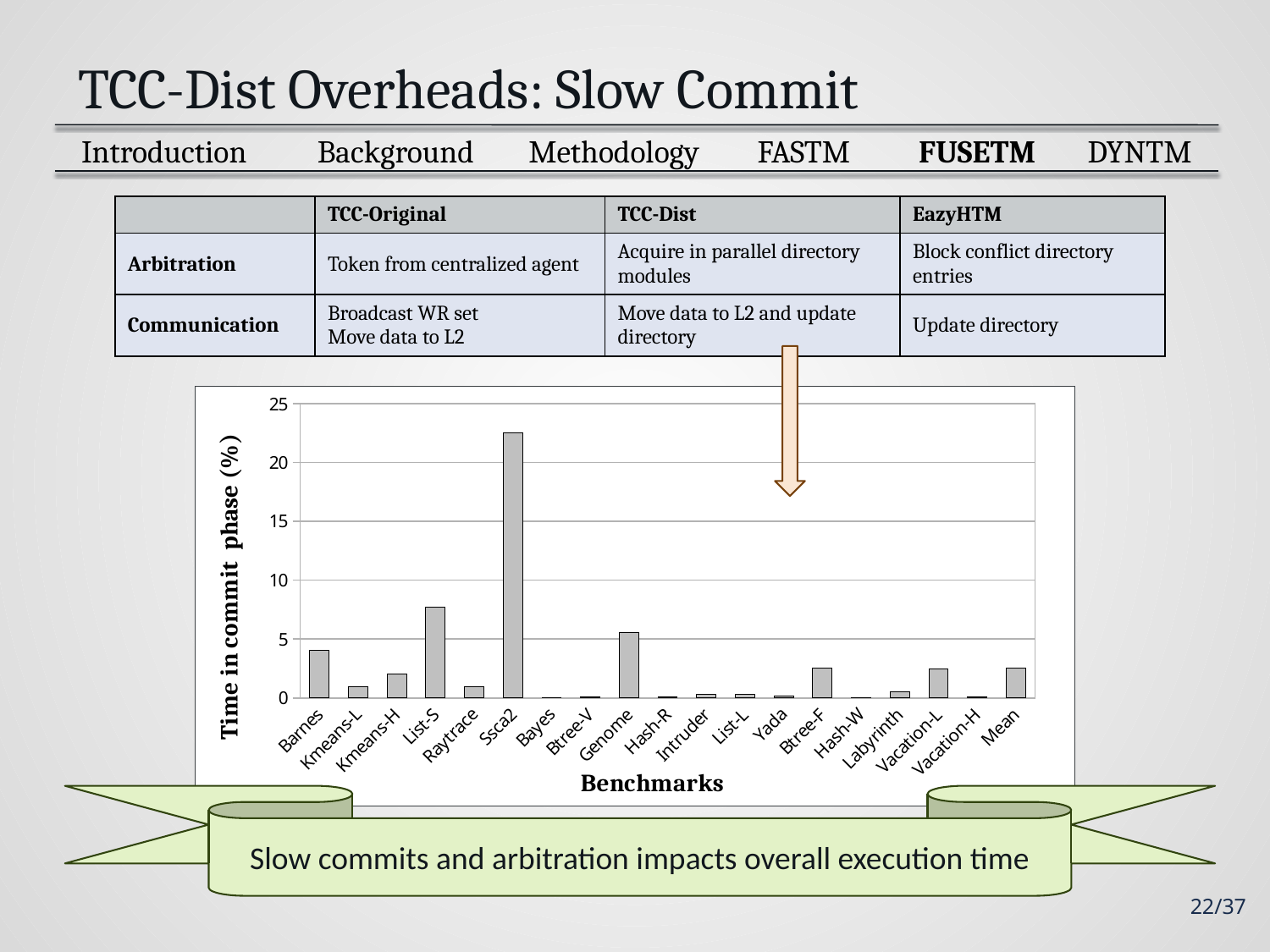
What is the label of the y axis of the chart? Time in commit phase (%) Is the value for List-S greater or less than 5? greater Which has a higher time in commit phase, Barnes or Kmeans-L? Barnes Which has a higher time in commit phase, Ssca2 or Mean? Ssca2 What kind of chart is shown on the slide? bar chart Is the value for Genome greater or less than 10? less Which benchmark has the highest time in commit phase? Ssca2 What is the label of the x axis of the chart? Benchmarks Is the value for Ssca2 greater or less than 20? greater Which has a higher time in commit phase, List-S or Genome? List-S How many benchmark categories (including Mean) are plotted on the x axis? 19